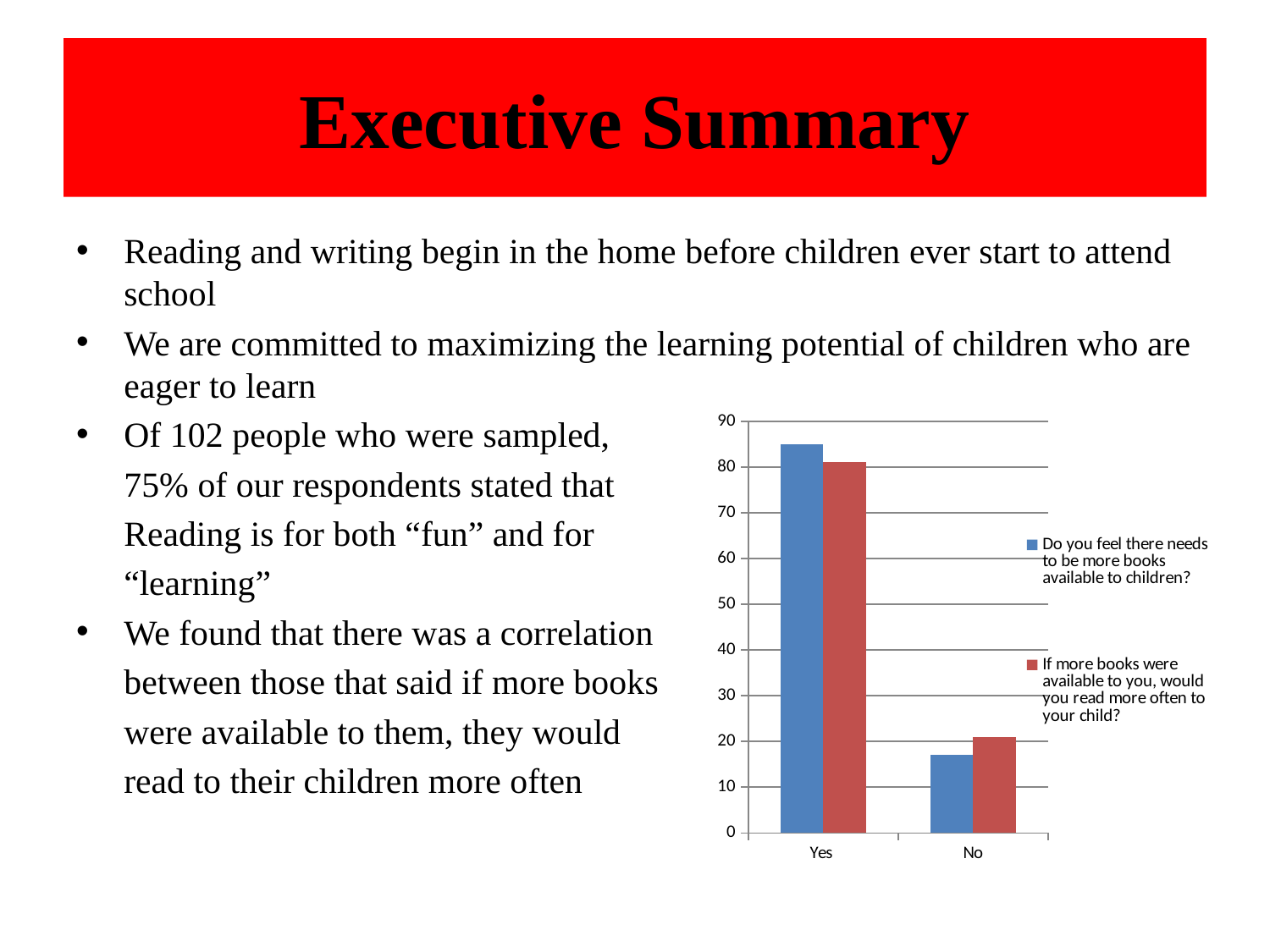
Which category has the higher value for the series "Do you feel there needs to be more books available to children?"? Yes Is the value for "No" in the series "If more books were available to you, would you read more often to your child?" greater or less than 30? less How many categories are shown on the x axis of the chart? 2 Is the value for "Yes" in the series "Do you feel there needs to be more books available to children?" greater or less than 80? greater For the "No" category, which series has the larger value? If more books were available to you, would you read more often to your child? Which series is shown in blue in the chart? Do you feel there needs to be more books available to children? What is the highest value shown on the chart's vertical axis? 90 Is the value for "Yes" in the series "If more books were available to you, would you read more often to your child?" greater or less than 70? greater How many series does the chart's legend list? 2 Which category has the lowest value for the series "If more books were available to you, would you read more often to your child?"? No What kind of chart is shown on the slide? bar chart